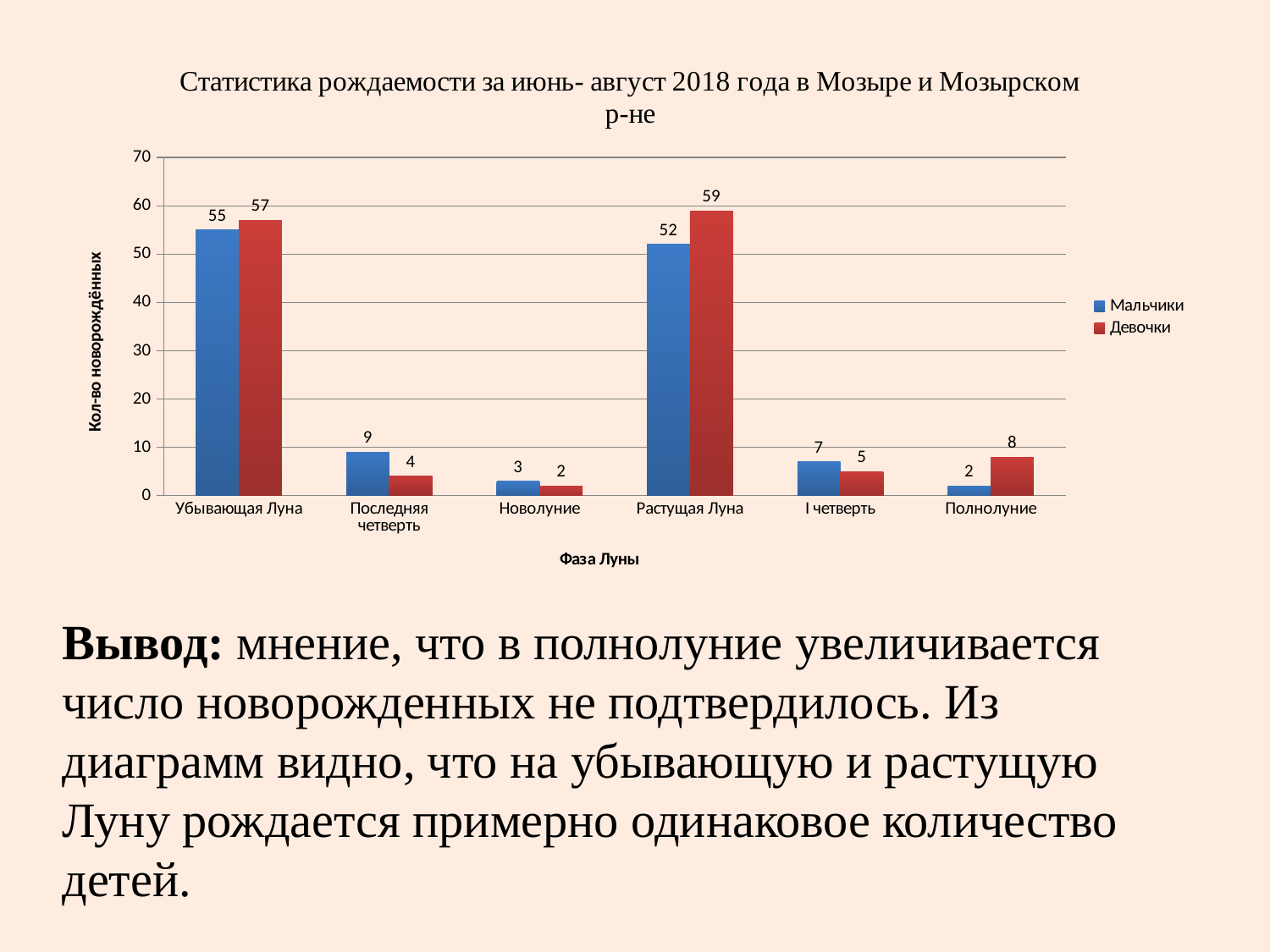
How many categories are shown on the x axis? 6 What is the difference between Девочки and Мальчики in the Растущая Луна category? 7 Which category has the highest value for Девочки? Растущая Луна What kind of chart is shown on the slide? bar chart Which category has the lowest value for Мальчики? Полнолуние Which is larger in the Последняя четверть category, Мальчики or Девочки? Мальчики What is the value for Девочки in the Полнолуние category? 8 What is the value for Девочки in the Растущая Луна category? 59 What is the value for Мальчики in the Убывающая Луна category? 55 Is the value for Мальчики in the Растущая Луна category greater or less than 50? greater How many series does the legend list? 2 What is the label of the x axis? Фаза Луны